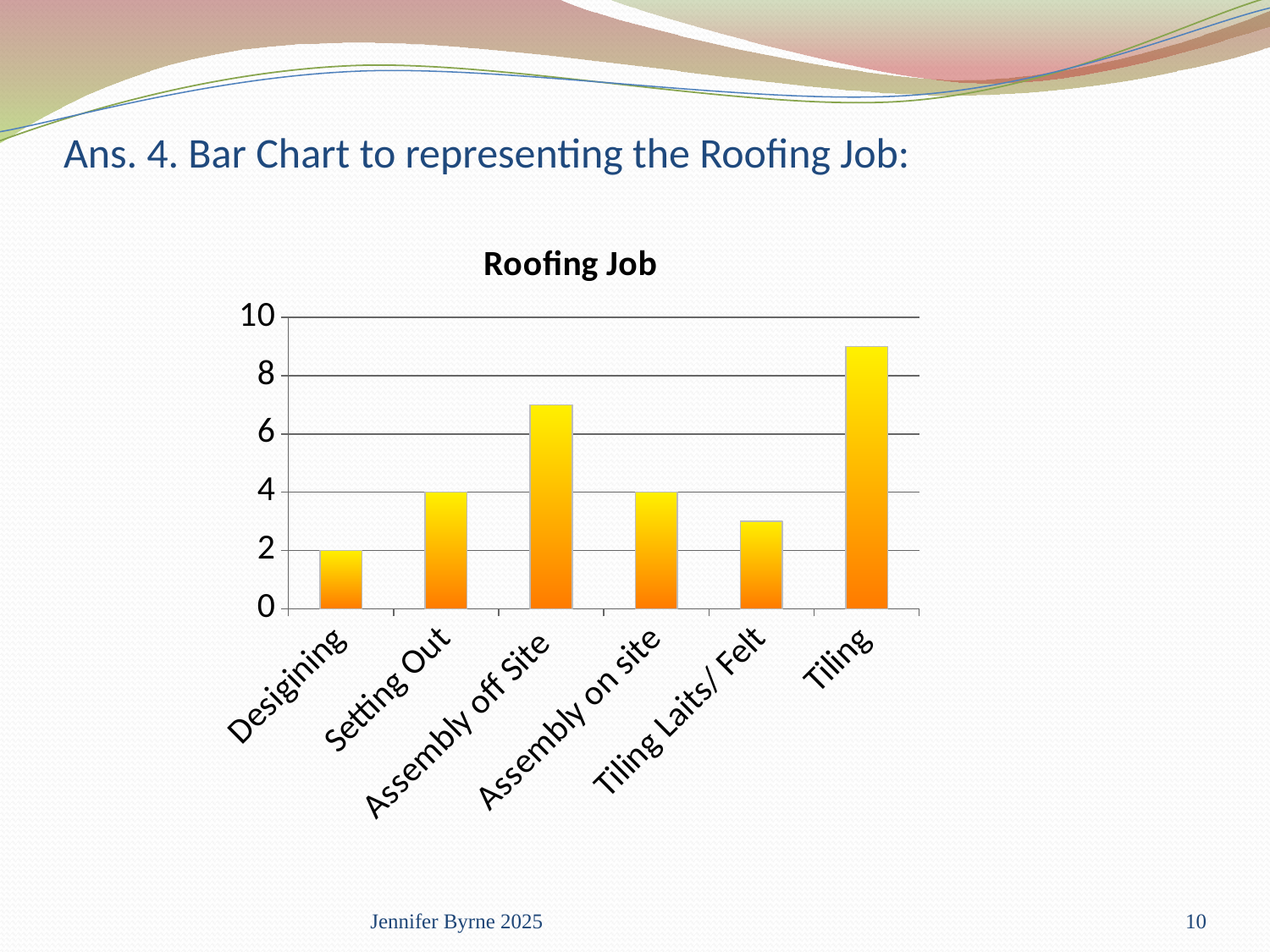
What is the title of the chart? Roofing Job What is the difference between the values for Setting Out and Desigining? 2 What is the value for Setting Out? 4 What is the value for Desigining? 2 Is the value for Tiling Laits/ Felt greater or less than 4? less Which category has the highest value? Tiling Is the value for Tiling greater or less than 8? greater What type of chart is shown on the slide? Bar chart Which is larger, the value for Assembly off Site or the value for Setting Out? Assembly off Site Which category has the lowest value? Desigining What is the value for Assembly on site? 4 How many categories are shown on the x axis of the chart? 6